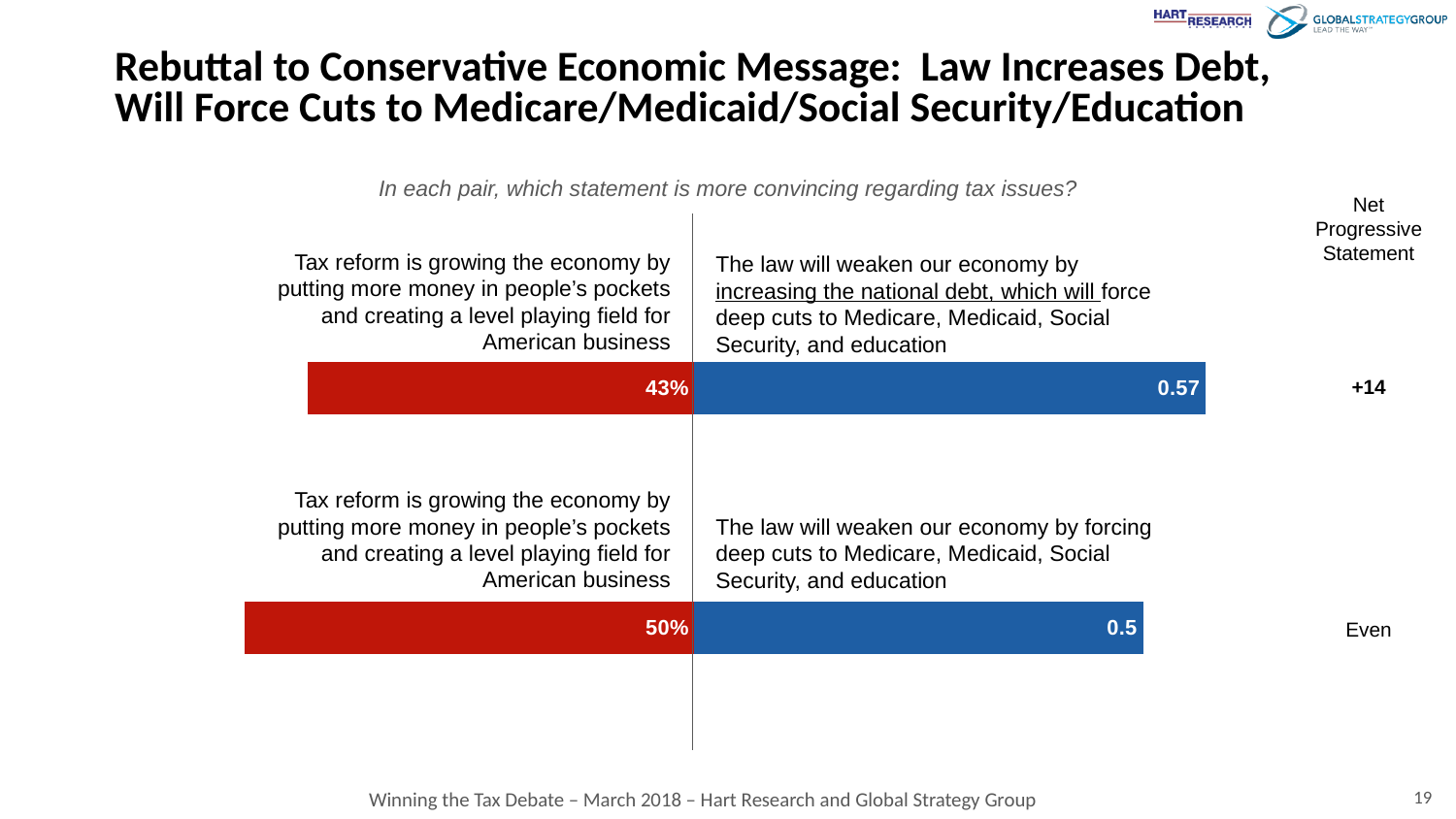
In the first pair, which statement was found more convincing: the conservative statement or the progressive statement? The progressive statement What colour are the bars representing the conservative statements? Red What is the Net Progressive Statement result shown for the second pair? Even What is the difference between the red bar values for the conservative statement in the second pair and the first pair? 7% What percentage chose the conservative statement (red bar) in the first pair, where the progressive statement mentions increasing the national debt? 43% What value is printed on the blue bar for the progressive statement in the first pair (the one mentioning the national debt)? 0.57 How many pairs of statements are shown in the chart? 2 Which pair has the larger red bar for the conservative statement, the first or the second? The second pair What value is printed on the blue bar for the progressive statement in the second pair? 0.5 What kind of chart is shown on the slide? Bar chart What percentage chose the conservative statement (red bar) in the second pair, where the progressive statement does not mention the national debt? 50% What is the Net Progressive Statement figure shown for the first pair? +14